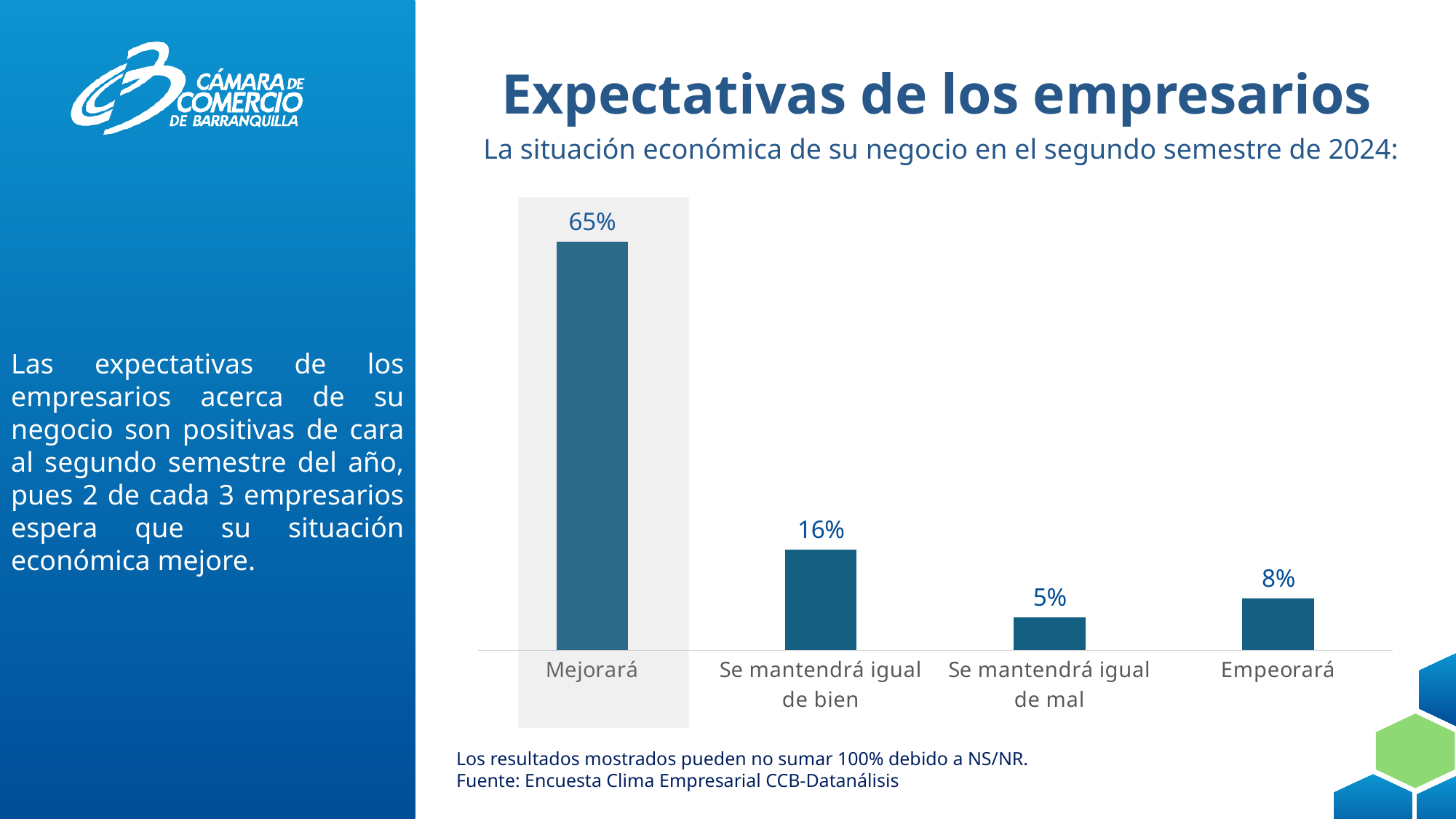
What percentage of business owners expect their situation to improve (Mejorará)? 65% Which category has the highest value? Mejorará What is the value for 'Se mantendrá igual de mal'? 5% Which category has the lowest value? Se mantendrá igual de mal What percentage of business owners expect their situation to worsen (Empeorará)? 8% What kind of chart is shown on the slide? Bar chart What is the value for 'Se mantendrá igual de bien'? 16% What is the difference between the values for 'Empeorará' and 'Se mantendrá igual de mal'? 3% Which is larger, the value for 'Empeorará' or for 'Se mantendrá igual de mal'? Empeorará What is the difference between the values for 'Mejorará' and 'Se mantendrá igual de bien'? 49% What is the source cited below the chart? Encuesta Clima Empresarial CCB-Datanálisis How many categories are shown in the chart? 4